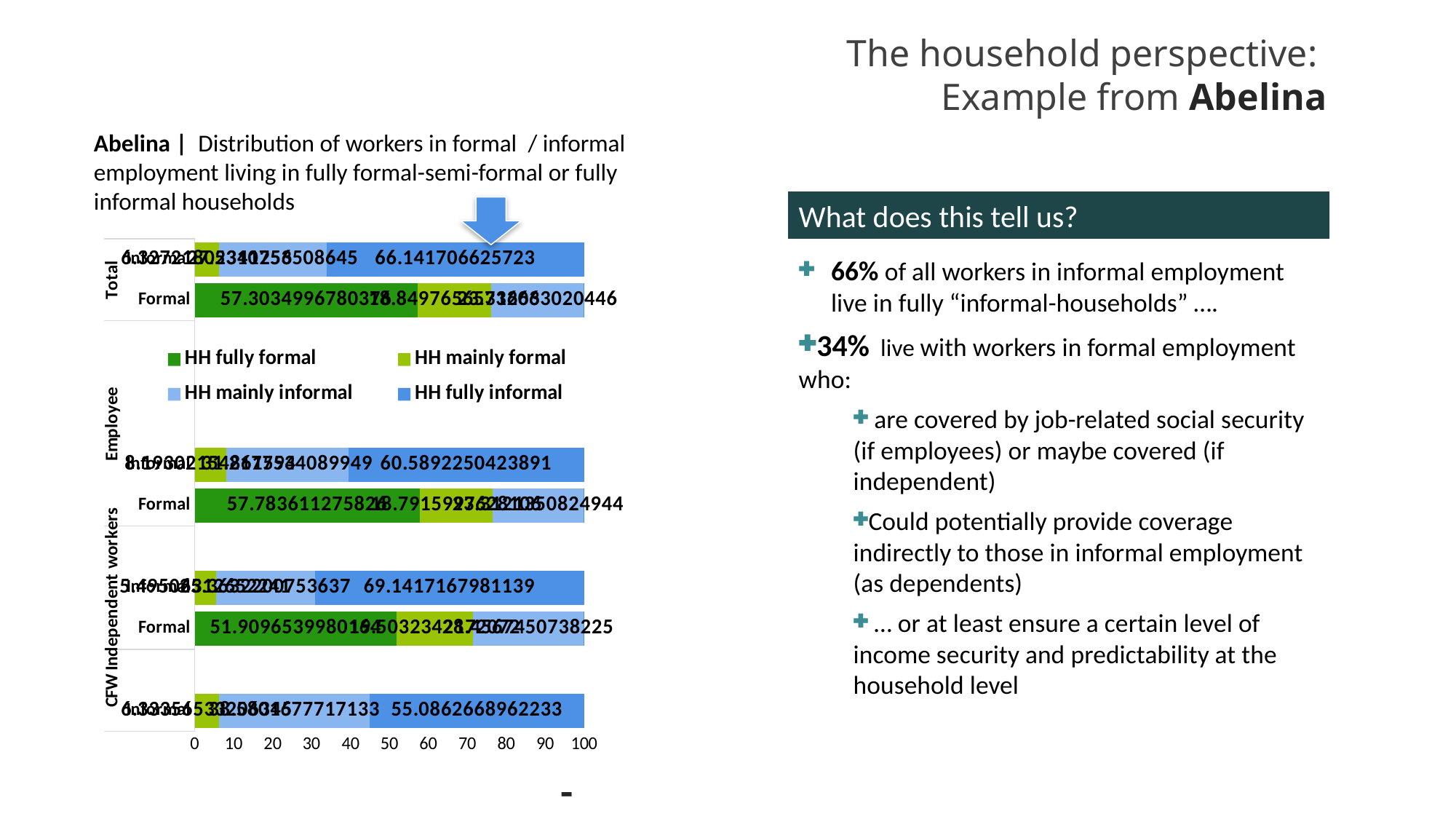
What is the HH fully informal value for the Employee Informal bar? 60.5892250423891 Among the Informal bars, which group has the highest HH fully informal value? Independent workers Among the Informal bars, which group has the lowest HH fully informal value? CFW Which series is shown in dark green in the chart legend? HH fully formal What is the HH fully informal value for the CFW Informal bar? 55.0862668962233 What is the HH fully informal value for the Independent workers Informal bar? 69.1417167981139 How many series does the chart legend list? 4 Is the HH fully informal value larger for the Total Informal bar or the Employee Informal bar? Total Informal What kind of chart is shown on the slide? stacked bar chart Is the HH fully formal value for the Total Formal bar greater or less than 50? greater What is the HH fully informal value for the Total Informal bar? 66.141706625723 How many bars are plotted in the chart? 7